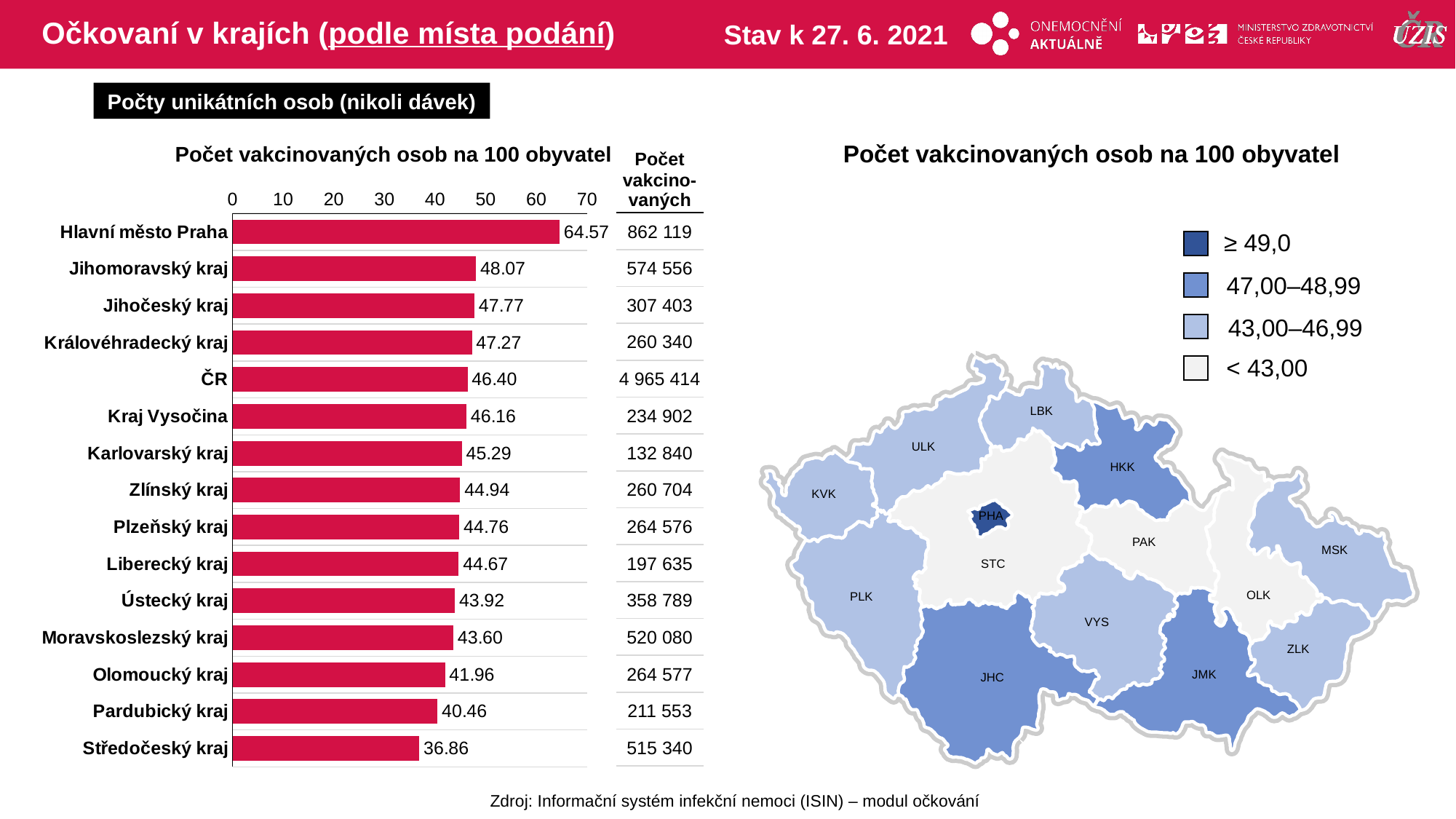
In the bar chart, which has a larger value: Jihomoravský kraj or Jihočeský kraj? Jihomoravský kraj In the bar chart, what is the value for Hlavní město Praha? 64.57 In the bar chart, is the value for Hlavní město Praha greater or less than 60? greater How many value classes does the legend of the map on the right list? 4 Which region has the lowest number of vaccinated persons per 100 inhabitants in the bar chart? Středočeský kraj In the bar chart, what is the value for Karlovarský kraj? 45.29 In the bar chart, what is the difference between the values for Hlavní město Praha and Středočeský kraj? 27.71 Which region has the highest number of vaccinated persons per 100 inhabitants in the bar chart? Hlavní město Praha How many bars (categories) are shown in the bar chart? 15 What type of chart is used to show the number of vaccinated persons per 100 inhabitants on the left of the slide? bar chart In the bar chart, what is the value for ČR? 46.40 In the bar chart, what is the value for Středočeský kraj? 36.86